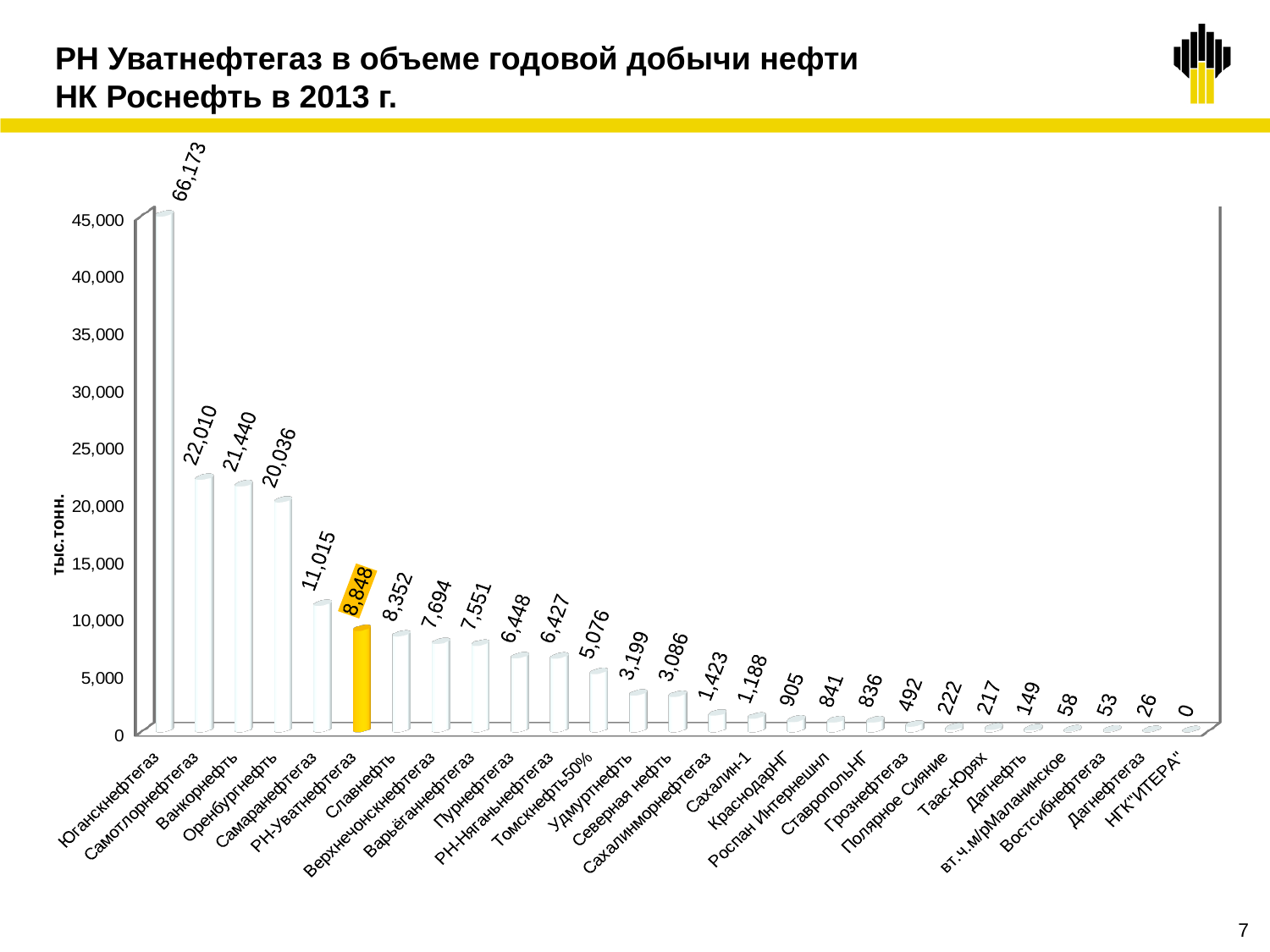
Is the value for Юганскнефтегаз greater or less than 45,000? greater What is the difference between the values for Самотлорнефтегаз and Оренбургнефть? 1,974 Which category has the highest value? Юганскнефтегаз What kind of chart is shown on the slide? bar chart How many categories are shown on the x axis? 27 What is the value for Томскнефть50%? 5,076 What is the value for Ванкорнефть? 21,440 Which is larger, the value for Славнефть or the value for Самаранефтегаз? Самаранефтегаз Do the values rise or fall from left to right along the x axis? fall Which category has the lowest value? НГК"ИТЕРА" Which bar is highlighted in yellow? РН-Уватнефтегаз What is the value for РН-Уватнефтегаз? 8,848